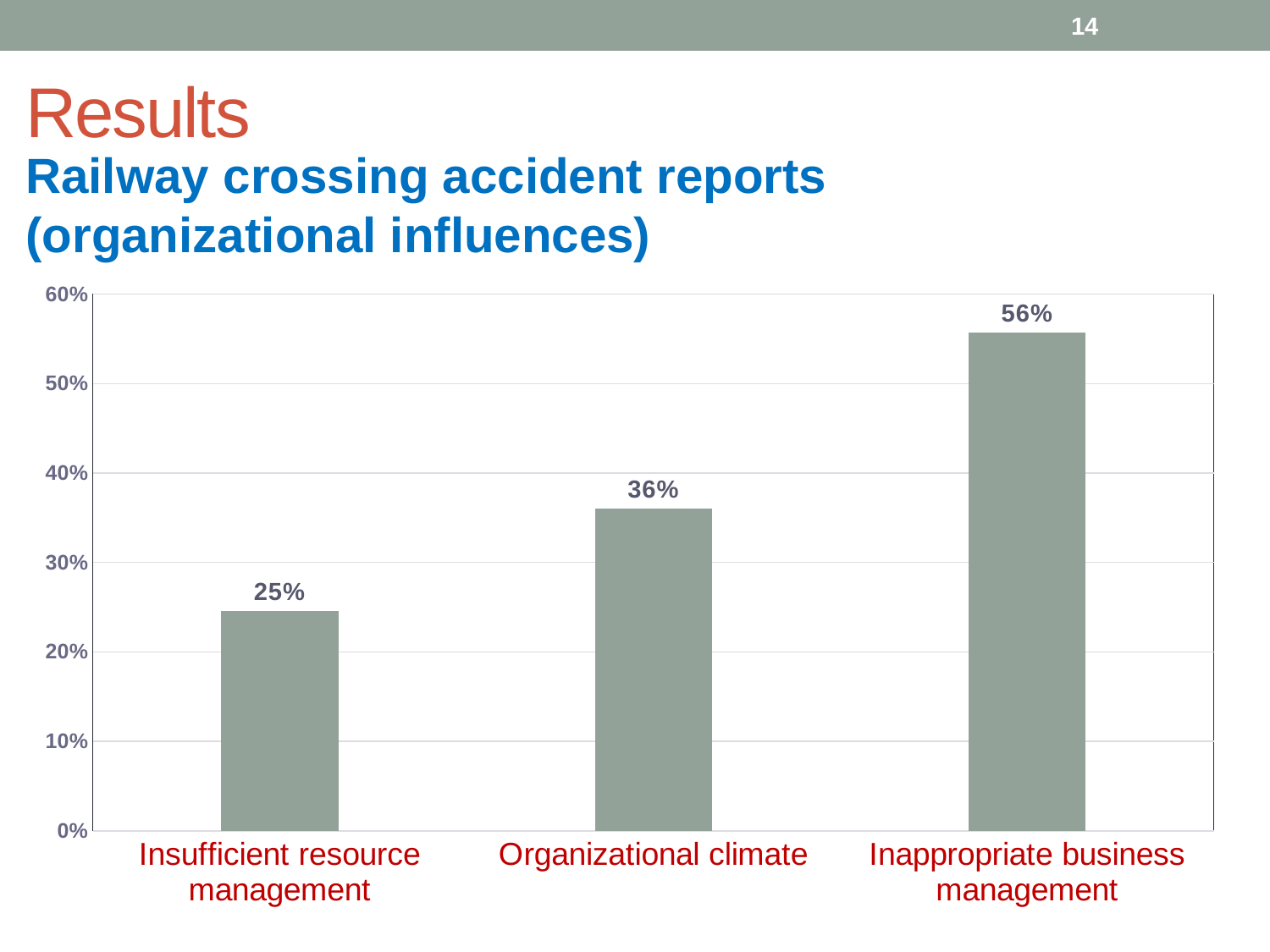
Do the values rise or fall from left to right across the categories? Rise How many categories are shown in the chart? 3 What is the value for Inappropriate business management? 56% Which category has the highest value? Inappropriate business management Which is larger, the value for Organizational climate or the value for Insufficient resource management? Organizational climate What is the difference between the values for Inappropriate business management and Organizational climate? 20% Which category has the lowest value? Insufficient resource management What is the difference between the values for Organizational climate and Insufficient resource management? 11% Is the value for Inappropriate business management greater or less than 50%? greater What is the value for Insufficient resource management? 25% What kind of chart is shown on the slide? Bar chart What is the value for Organizational climate? 36%